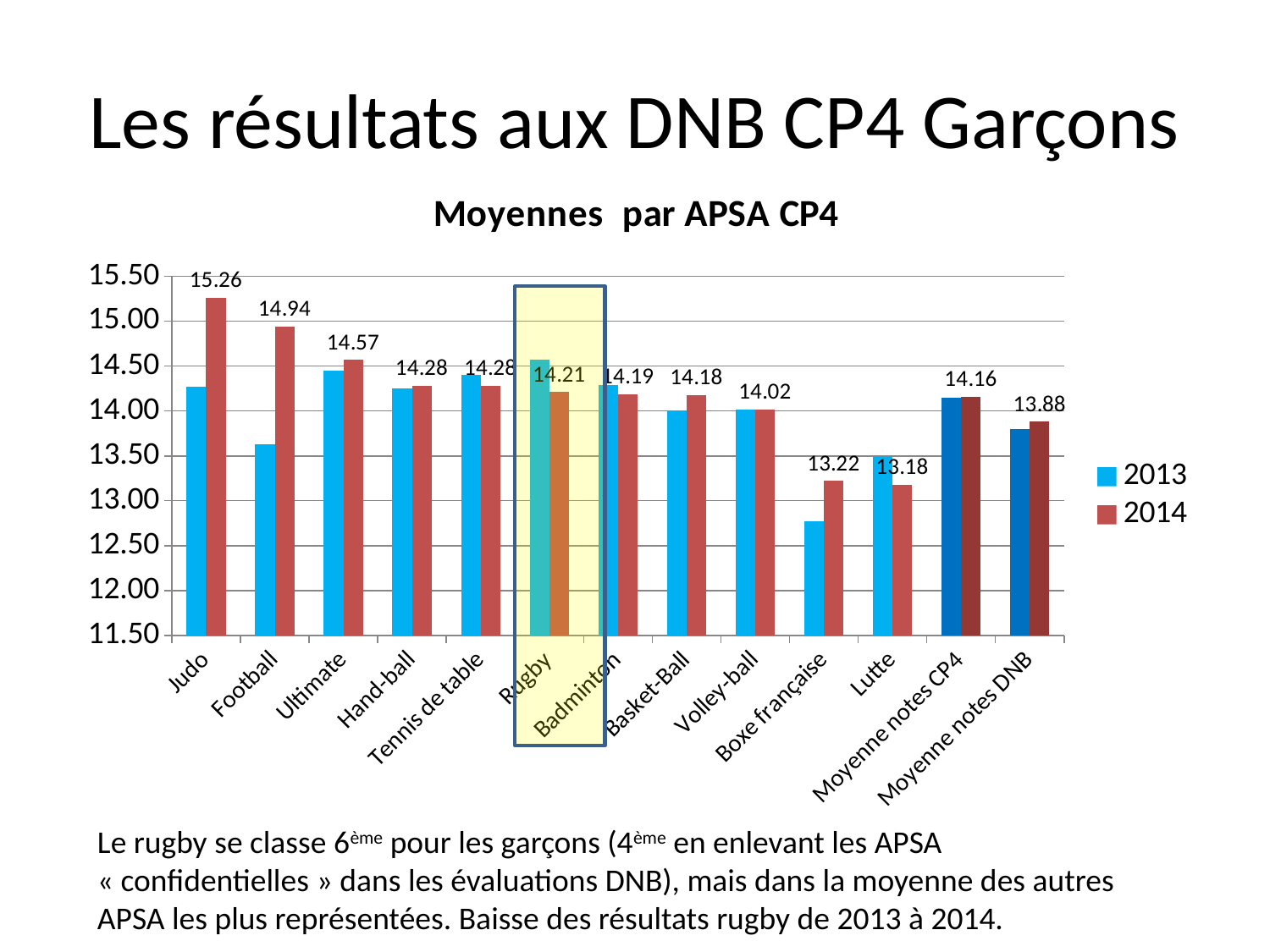
Is the 2013 value for Football greater or less than 14.00? less Which category has the highest 2014 value? Judo How many series does the legend list? 2 What is the difference between the 2014 values for Judo and Football? 0.32 What kind of chart is shown on the slide? bar chart What is the 2014 value for Moyenne notes DNB? 13.88 What is the 2014 value for Rugby? 14.21 Is the 2013 value for Boxe française greater or less than 13.00? less How many categories are shown on the x axis? 13 Which category has the lowest 2014 value? Lutte Which is larger, the 2014 value for Badminton or the 2014 value for Basket-Ball? Badminton What is the 2014 value for Judo? 15.26